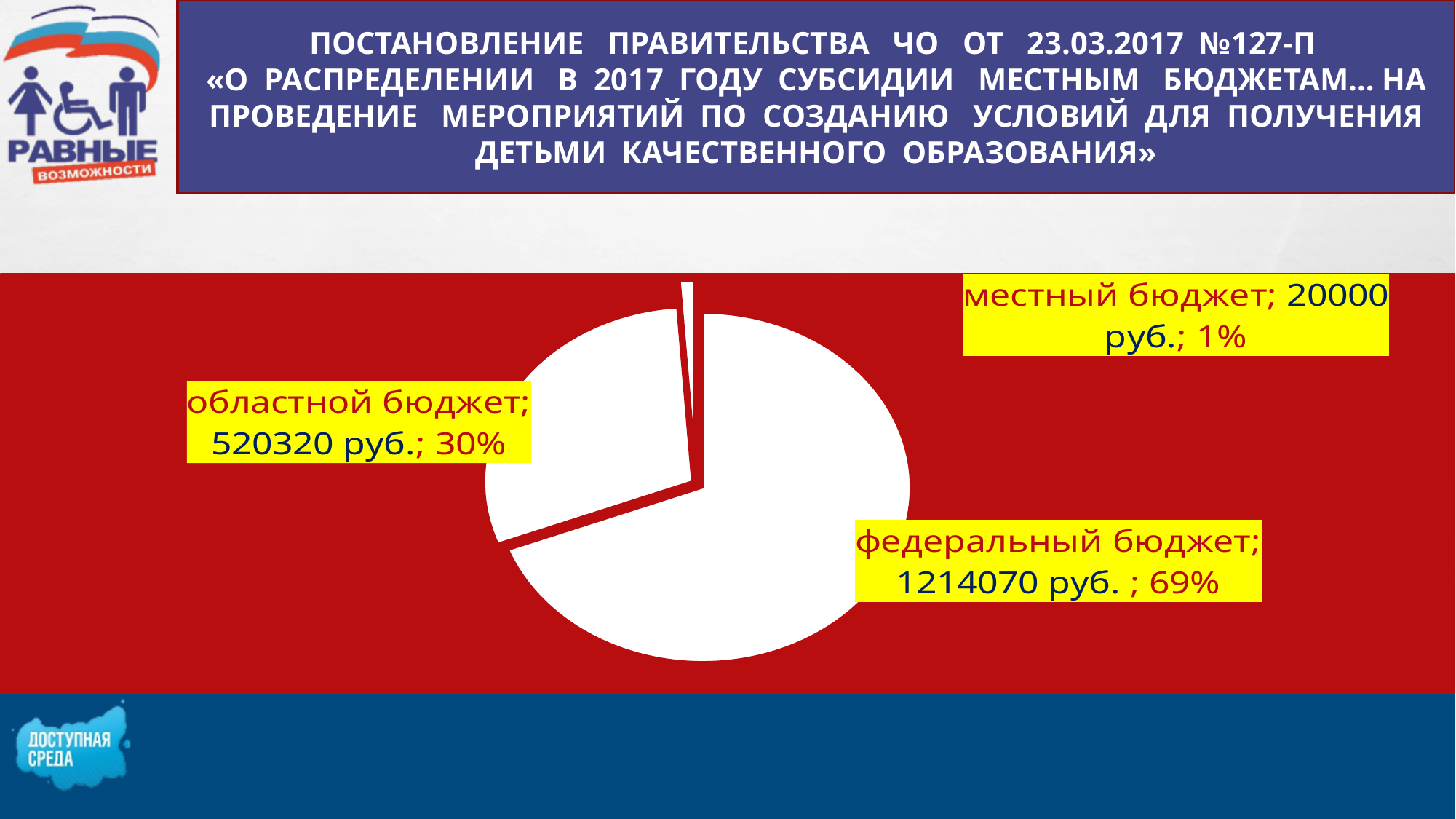
What is the value for областной бюджет in the pie chart? 520320 руб. How many categories are shown in the pie chart? 3 Which category has the largest slice in the pie chart? федеральный бюджет Which category has the smallest slice in the pie chart? местный бюджет What share of the pie does местный бюджет represent? 1% What is the difference between the values for федеральный бюджет and областной бюджет? 693750 руб. Which is larger, the value for областной бюджет or the value for местный бюджет? областной бюджет What is the value for местный бюджет in the pie chart? 20000 руб. What is the value for федеральный бюджет in the pie chart? 1214070 руб. What share of the pie does областной бюджет represent? 30% What share of the pie does федеральный бюджет represent? 69% What kind of chart is shown on the slide? pie chart